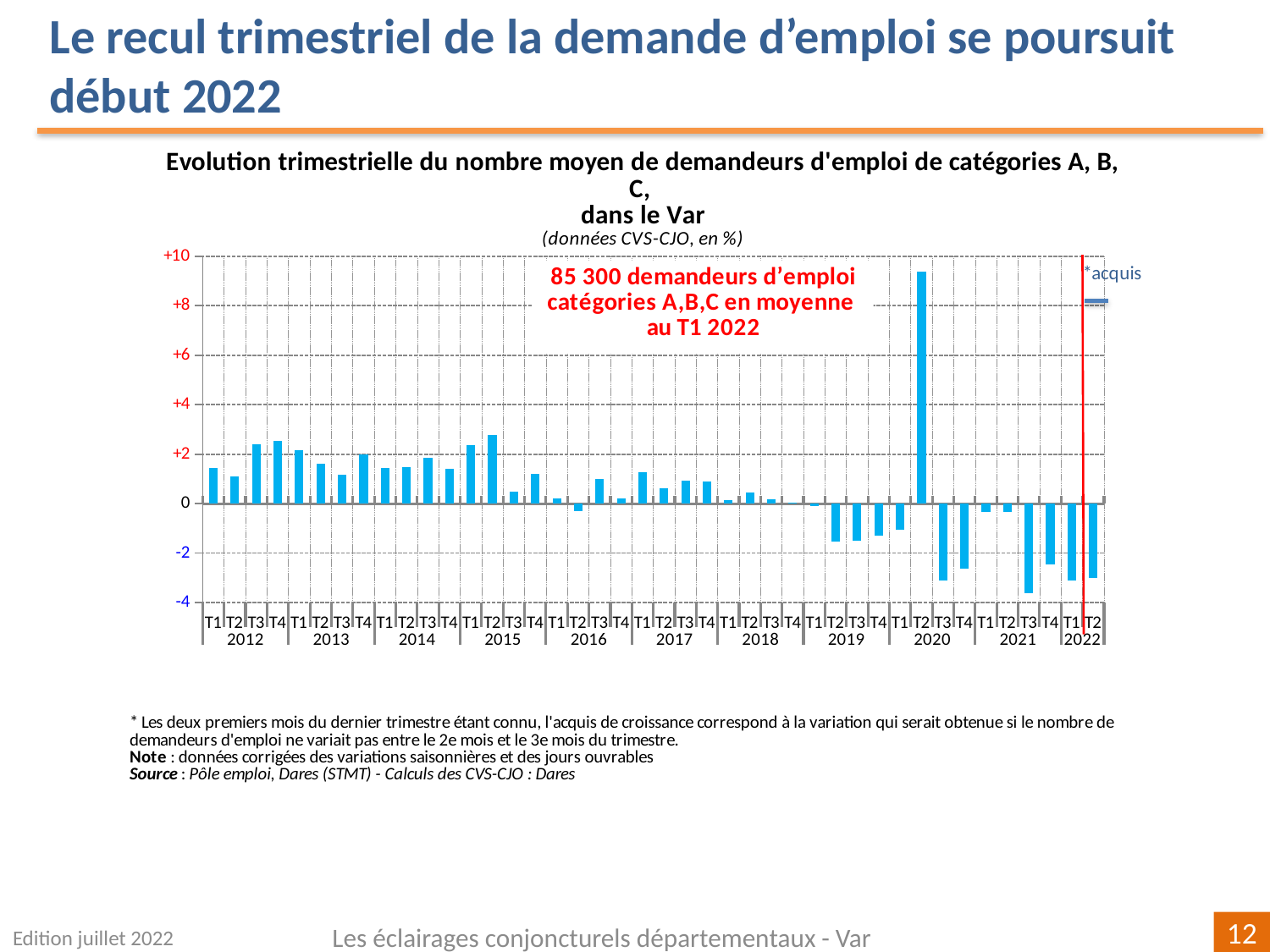
Which quarter has the highest value in the chart? T2 2020 How many years are labelled on the x axis of the chart? 11 What kind of chart is shown on the slide? bar chart Do the values rise or fall from T2 2020 to T3 2020? fall Which is larger, the value for T2 2020 or the value for T2 2015? T2 2020 Which is larger, the value for T3 2012 or the value for T1 2012? T3 2012 Is the value for T2 2020 greater or less than +8? greater Is the value for T2 2019 greater or less than 0? less Is the value for T3 2021 greater or less than -2? less According to the annotation on the chart, how many demandeurs d'emploi catégories A,B,C were there on average in T1 2022? 85 300